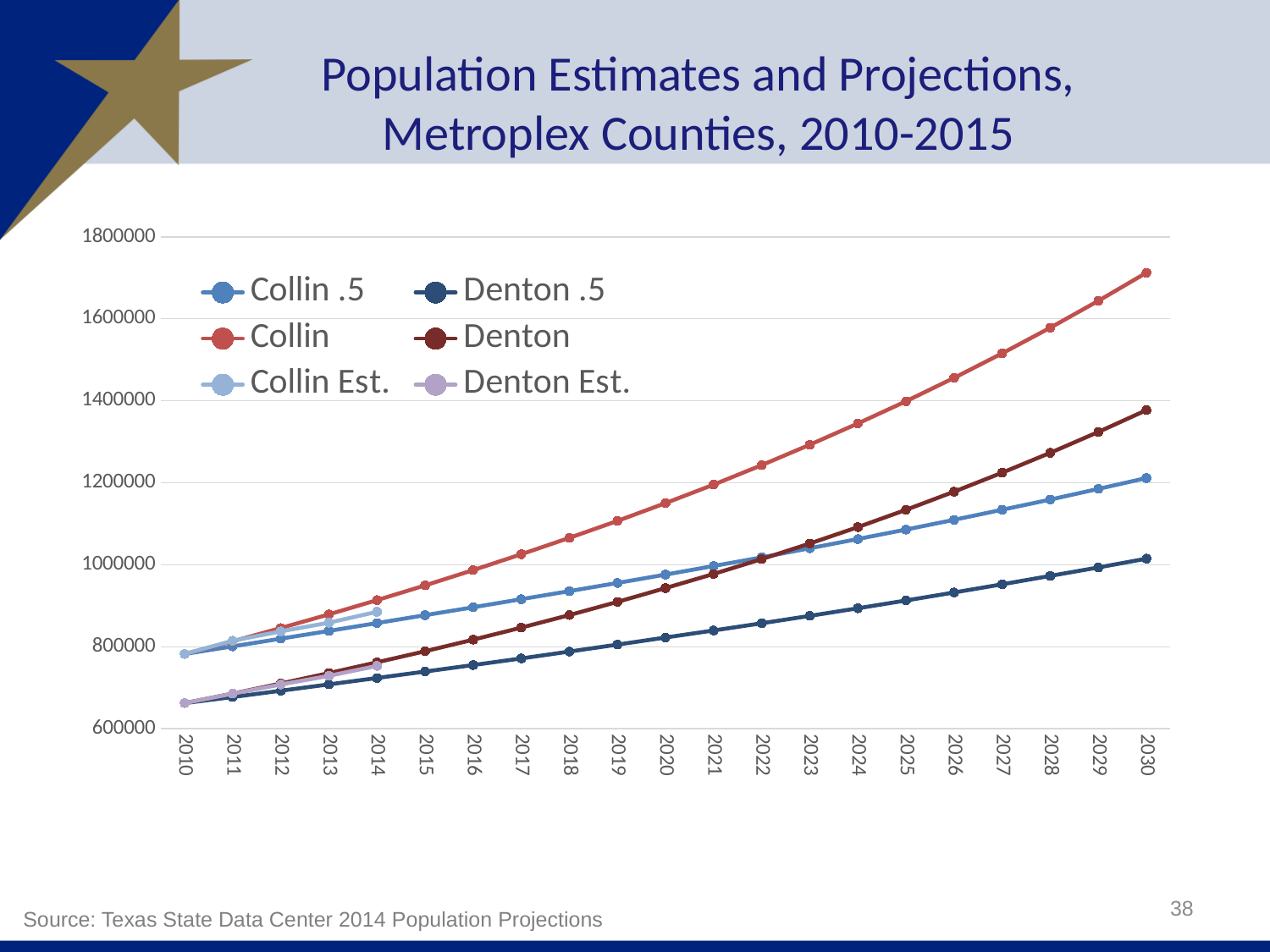
Is the value for Collin .5 in 2030 greater or less than 1000000? greater Which series has the lowest value in 2030? Denton .5 How many years are shown along the x axis of the chart? 21 Is the value for Denton .5 in 2030 greater or less than 1200000? less In 2030, which is larger: the value for Denton or the value for Collin .5? Denton Is the value for Collin in 2030 greater or less than 1600000? greater Which series has the highest value in 2030? Collin How many series does the chart's legend list? 6 What kind of chart is shown on the slide? line chart Does the Collin series rise or fall from 2010 to 2030? rise What is the title of the chart on the slide? Population Estimates and Projections, Metroplex Counties, 2010-2015